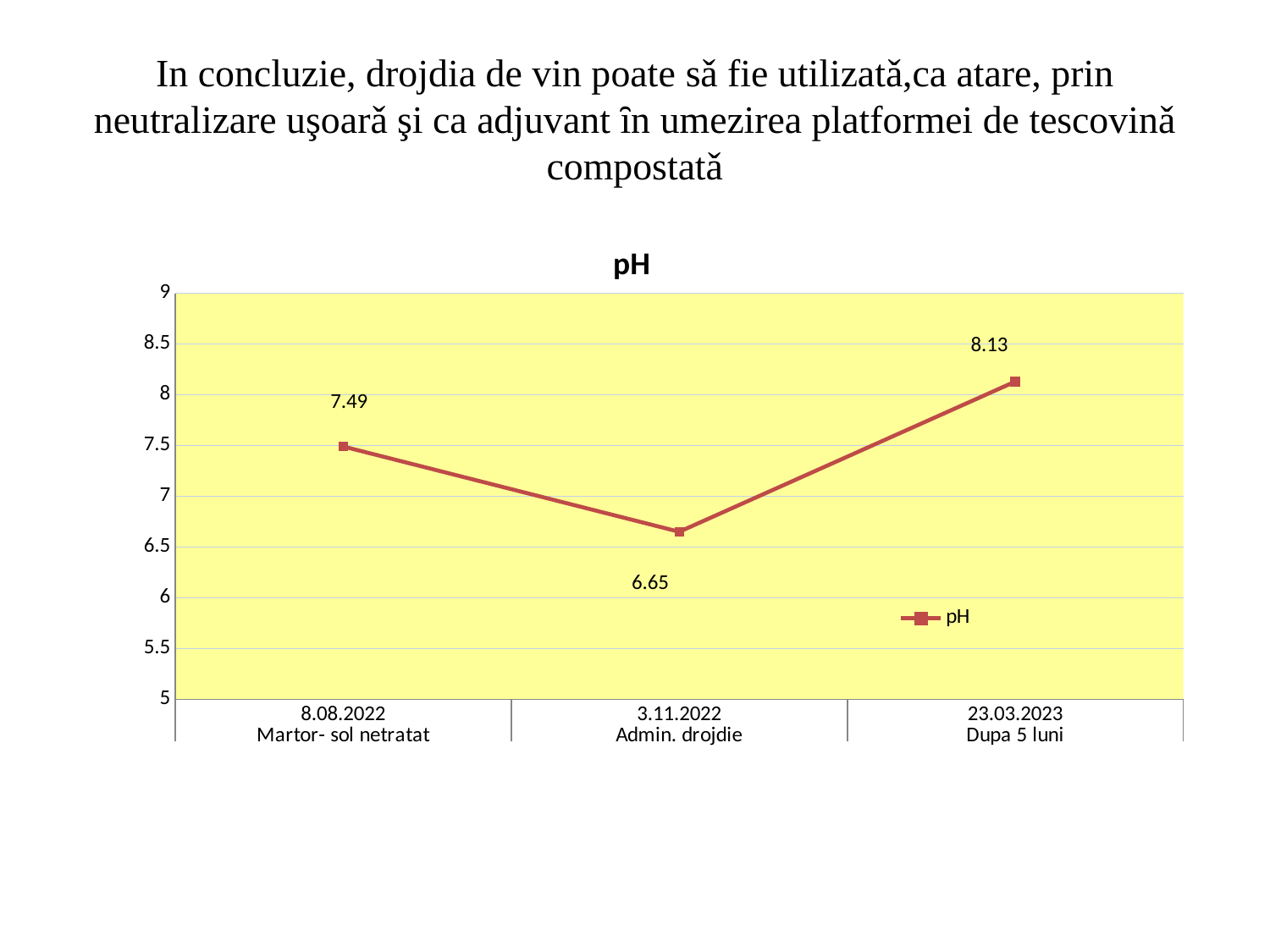
Which category has the lowest pH value? 3.11.2022 Admin. drojdie Which category has the highest pH value? 23.03.2023 Dupa 5 luni What is the difference between the pH values for 23.03.2023 Dupa 5 luni and 3.11.2022 Admin. drojdie? 1.48 Which is larger, the pH value for 8.08.2022 Martor- sol netratat or for 23.03.2023 Dupa 5 luni? 23.03.2023 Dupa 5 luni Is the pH value for 3.11.2022 Admin. drojdie greater or less than 7? less What is the pH value for 8.08.2022 Martor- sol netratat? 7.49 What is the difference between the pH values for 8.08.2022 Martor- sol netratat and 3.11.2022 Admin. drojdie? 0.84 What is the title of the chart? pH What is the pH value for 23.03.2023 Dupa 5 luni? 8.13 How many data points are plotted on the chart? 3 What kind of chart is shown on the slide? line chart What is the pH value for 3.11.2022 Admin. drojdie? 6.65